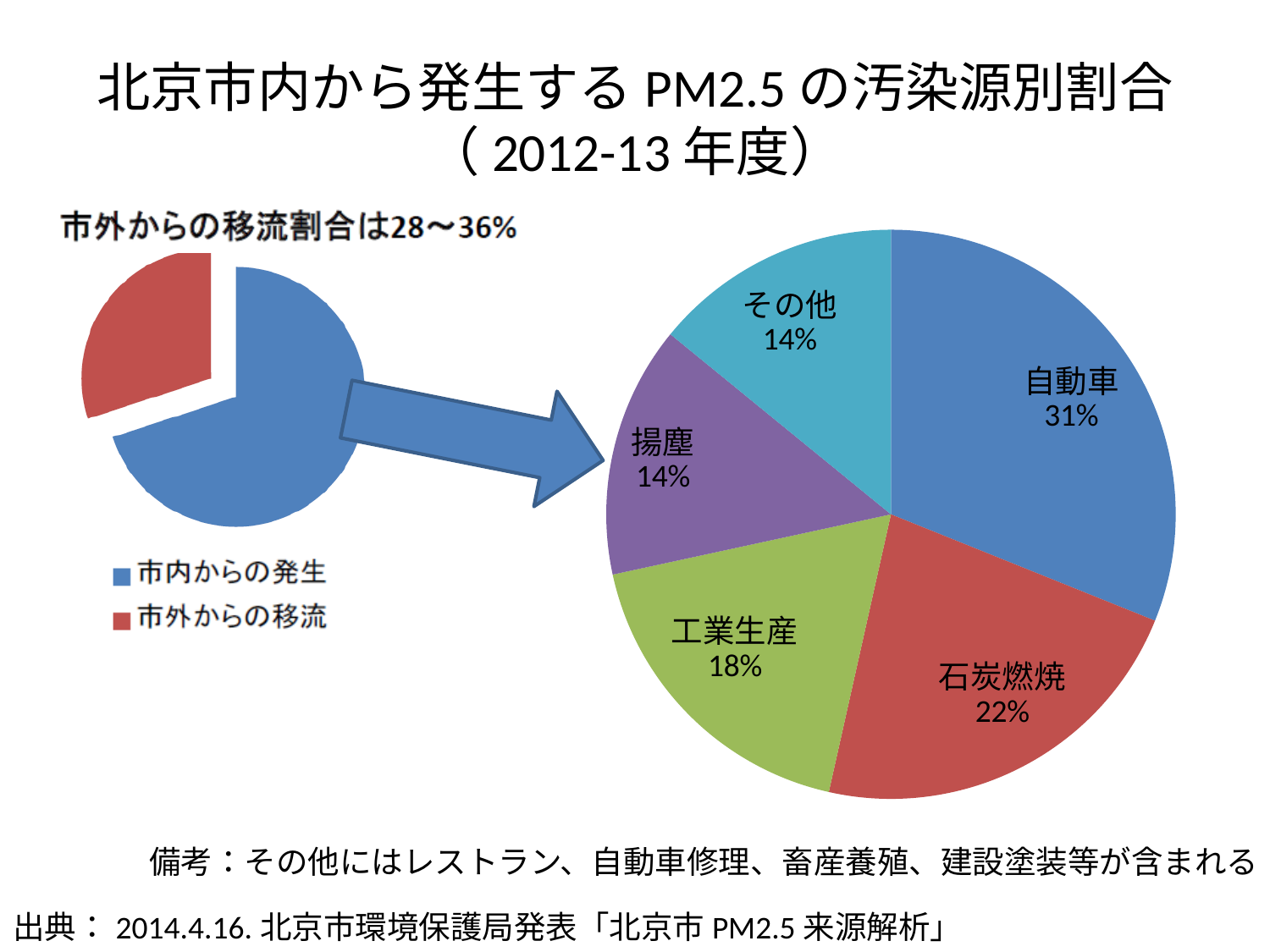
What kind of chart is the large chart on the right of the slide? Pie chart In the large pie chart on the right, what percentage is shown for 自動車? 31% How many categories does the small pie chart on the left have? 2 In the large pie chart on the right, which is larger, 工業生産 or 揚塵? 工業生産 In the large pie chart on the right, what is the difference in percentage points between 自動車 and 石炭燃焼? 9 percentage points In the large pie chart on the right, what percentage is shown for 石炭燃焼? 22% In the small pie chart on the left, what colour represents 市外からの移流? Red In the small pie chart on the left, which of the two categories is larger, 市内からの発生 or 市外からの移流? 市内からの発生 In the large pie chart on the right, what percentage is shown for 工業生産? 18% In the large pie chart on the right, which category has the largest share? 自動車 How many slices does the large pie chart on the right have? 5 In the large pie chart on the right, what share of the pie does その他 represent? 14%